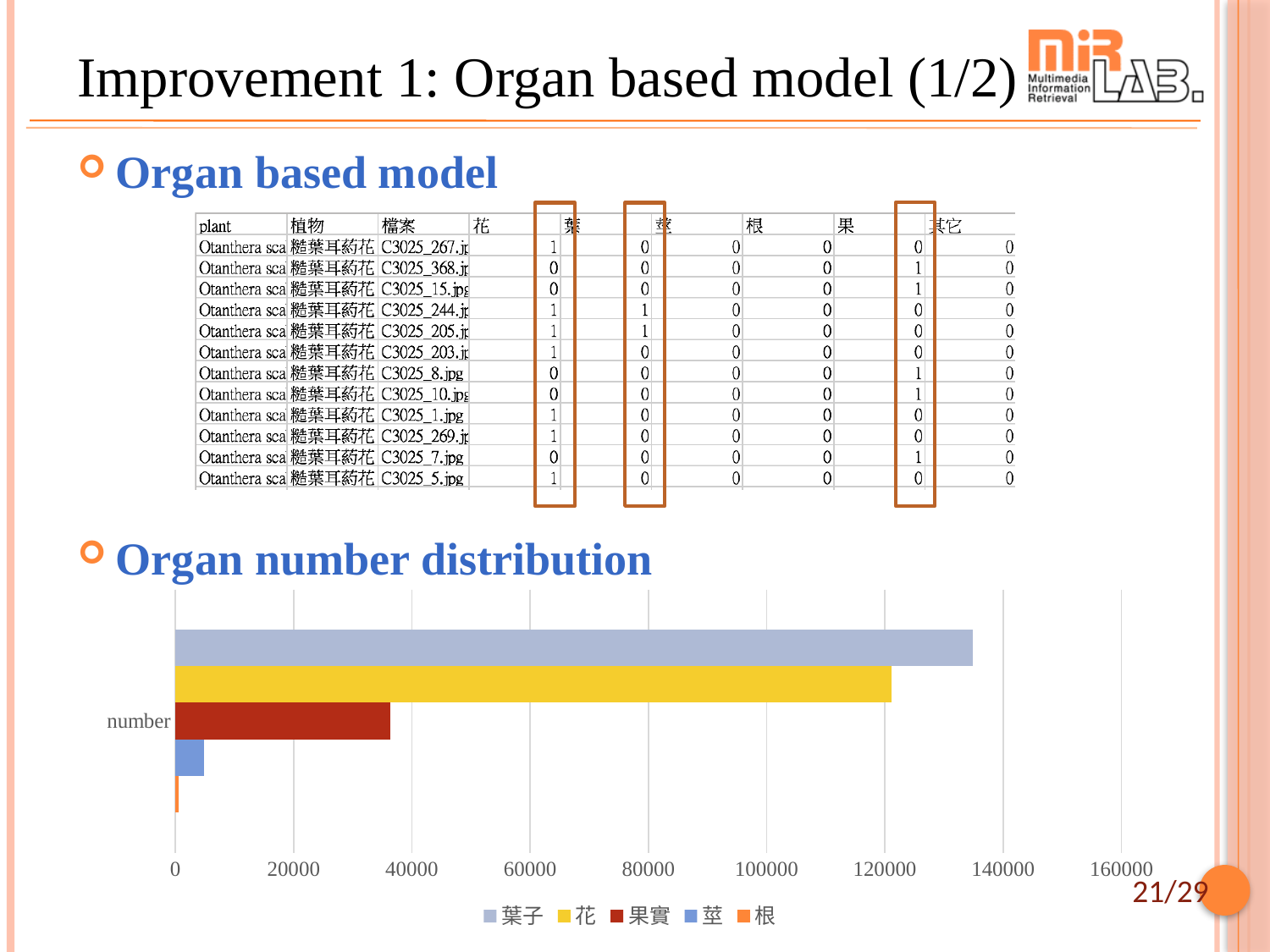
What kind of chart is shown under "Organ number distribution"? bar chart In the "Organ number distribution" chart, which series has the highest value? 葉子 How many categories are shown on the vertical axis of the "Organ number distribution" chart? 1 In the "Organ number distribution" chart, what colour is the bar for 花? yellow In the "Organ number distribution" chart, is the value for 果實 greater or less than 40000? less In the "Organ number distribution" chart, is the value for 莖 greater or less than 20000? less In the "Organ number distribution" chart, is the value for 葉子 greater or less than 120000? greater What is the label of the single category on the vertical axis of the "Organ number distribution" chart? number In the "Organ number distribution" chart, which is larger, the value for 花 or the value for 果實? 花 How many series does the legend of the "Organ number distribution" chart list? 5 In the "Organ number distribution" chart, which series has the lowest value? 根